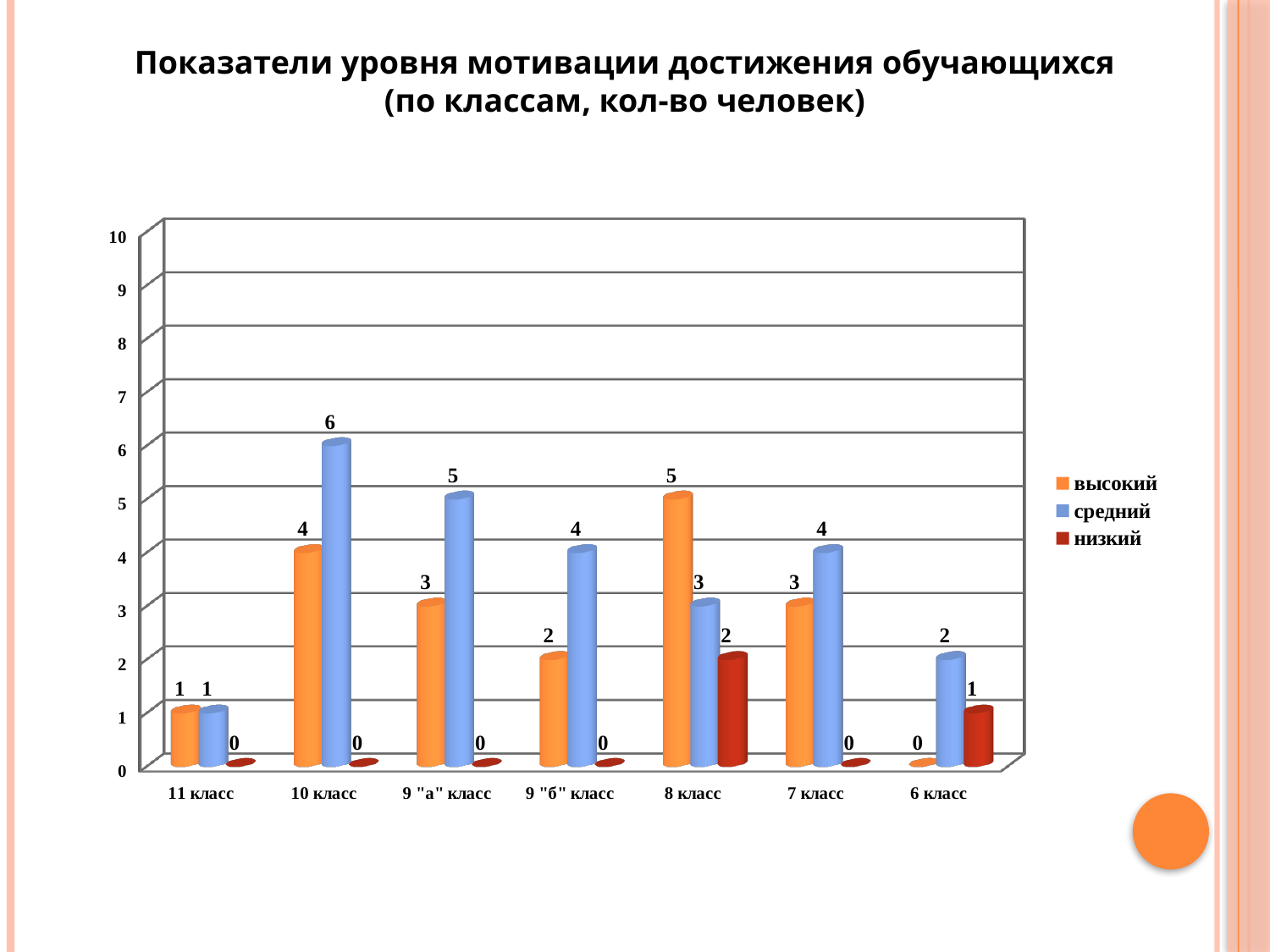
Which class has the lowest value for "высокий"? 6 класс What is the difference between "средний" and "высокий" in 9 "а" класс? 2 What is the value for "высокий" in 8 класс? 5 Which colour represents the "низкий" series in the legend? dark red Which class has the highest value for "средний"? 10 класс What kind of chart is shown on the slide? bar chart Which class has the highest value for "низкий"? 8 класс What is the value for "средний" in 10 класс? 6 How many series does the legend list? 3 Which is larger in 8 класс: "высокий" or "средний"? высокий What is the value for "низкий" in 6 класс? 1 How many classes are shown on the x axis? 7